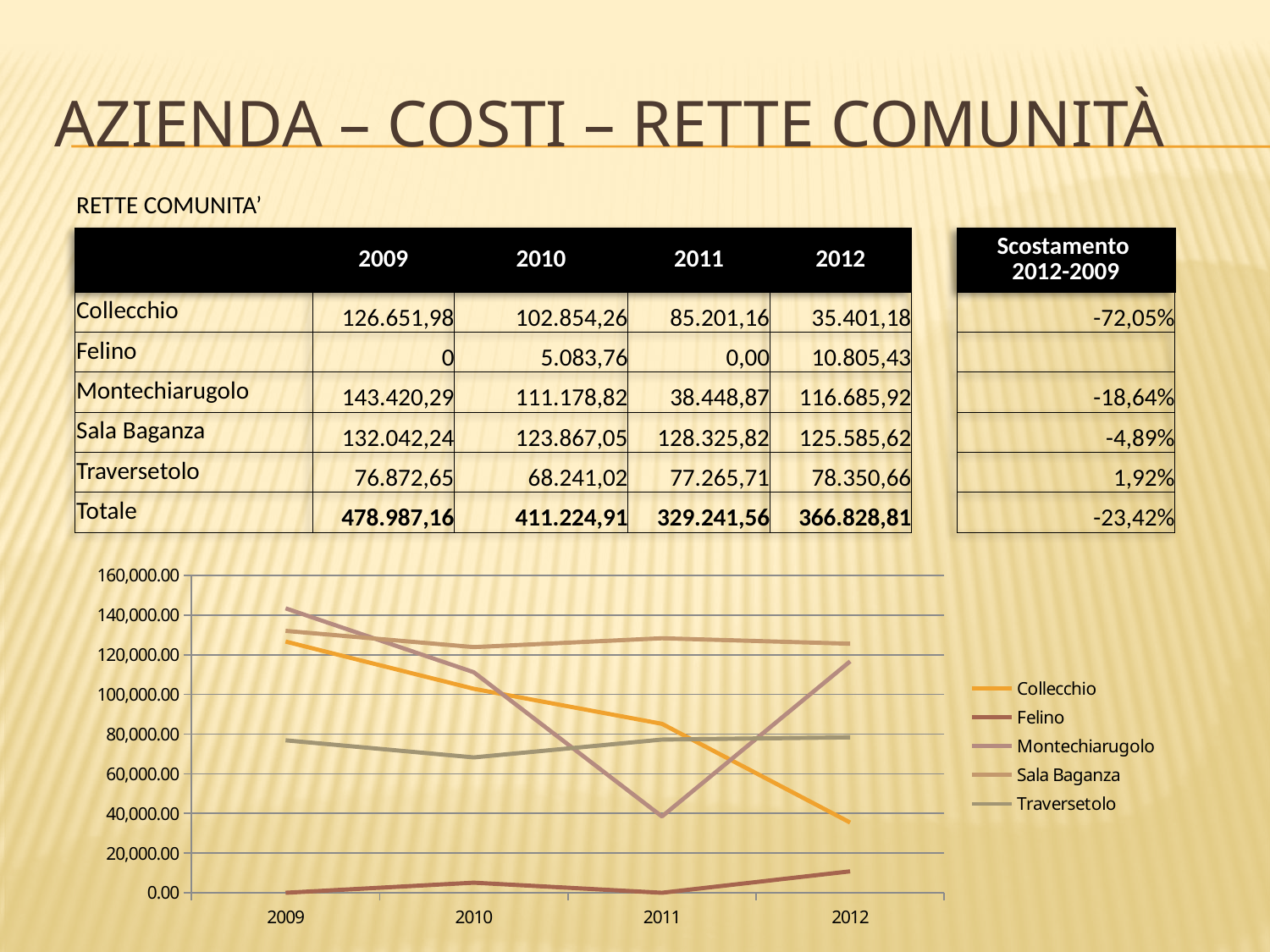
In 2010, which is larger: Traversetolo or Felino? Traversetolo How many years are plotted along the x axis of the chart? 4 Does the Collecchio line rise or fall from 2009 to 2012? Fall Which series has the lowest value in 2011? Felino What is the value for Montechiarugolo in 2011? 38.448,87 How many series does the chart legend list? 5 Is the value for Sala Baganza in 2012 greater or less than 120,000.00? greater What is the difference between the Traversetolo value in 2012 and in 2009? 1.478,01 What kind of chart is shown on the slide? Line chart Is the value for Montechiarugolo in 2011 greater or less than 60,000.00? less Which series has the highest value in 2009? Montechiarugolo What is the value for Collecchio in 2012? 35.401,18